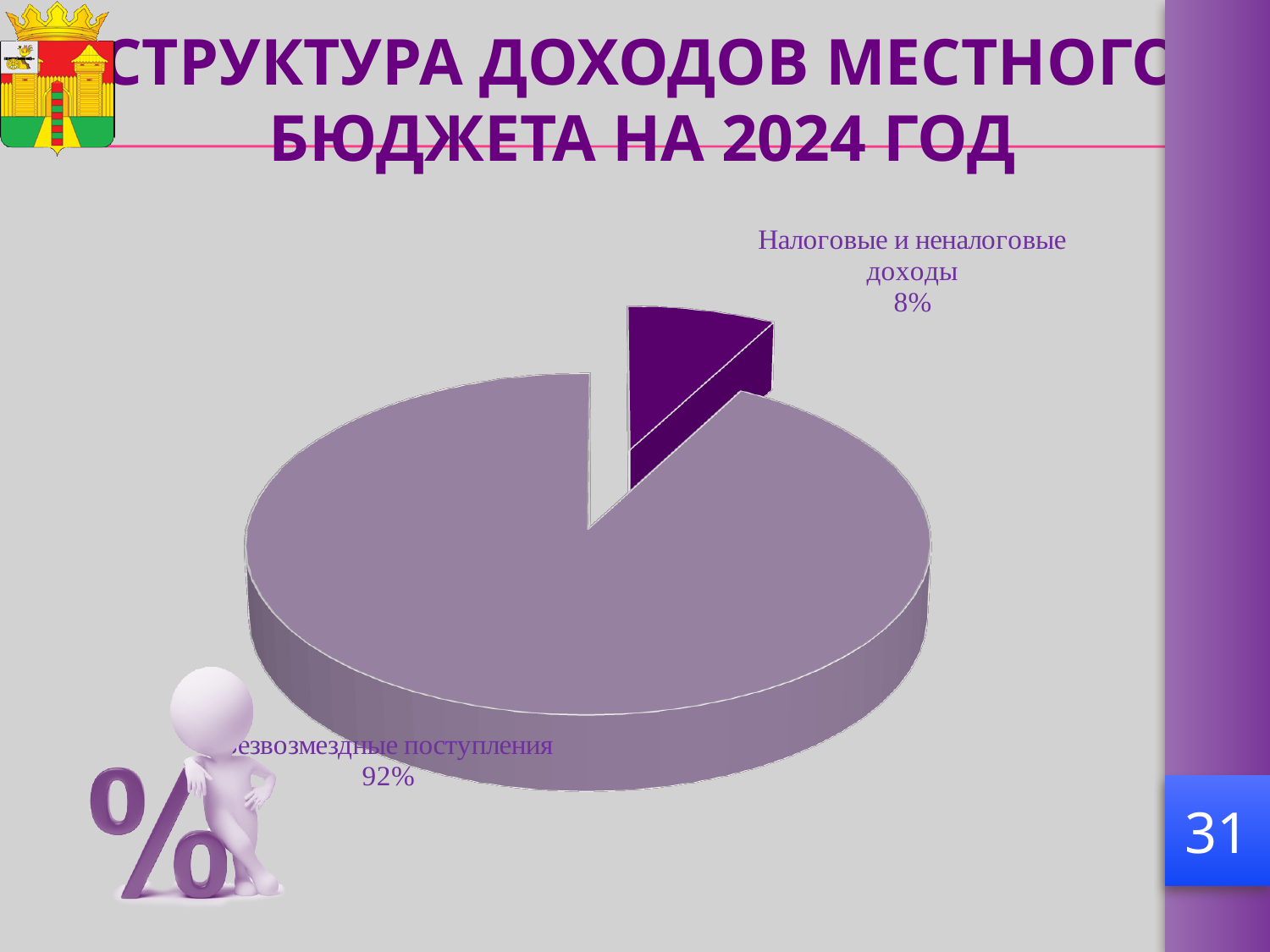
What share of the pie does "Налоговые и неналоговые доходы" have? 8% How many slices does the pie chart have? 2 What kind of chart is shown on the slide? Pie chart What is the difference in percentage points between "Безвозмездные поступления" and "Налоговые и неналоговые доходы"? 84 Which is larger: "Налоговые и неналоговые доходы" or "Безвозмездные поступления"? Безвозмездные поступления Which category has the smallest slice of the pie? Налоговые и неналоговые доходы What is the value shown for "Налоговые и неналоговые доходы"? 8% What is the value shown for "Безвозмездные поступления"? 92% Which category has the largest slice of the pie? Безвозмездные поступления What share of the pie does "Безвозмездные поступления" have? 92% What is the title of the slide containing the chart? СТРУКТУРА ДОХОДОВ МЕСТНОГО БЮДЖЕТА НА 2024 ГОД Which slice is drawn in the darker purple colour? Налоговые и неналоговые доходы